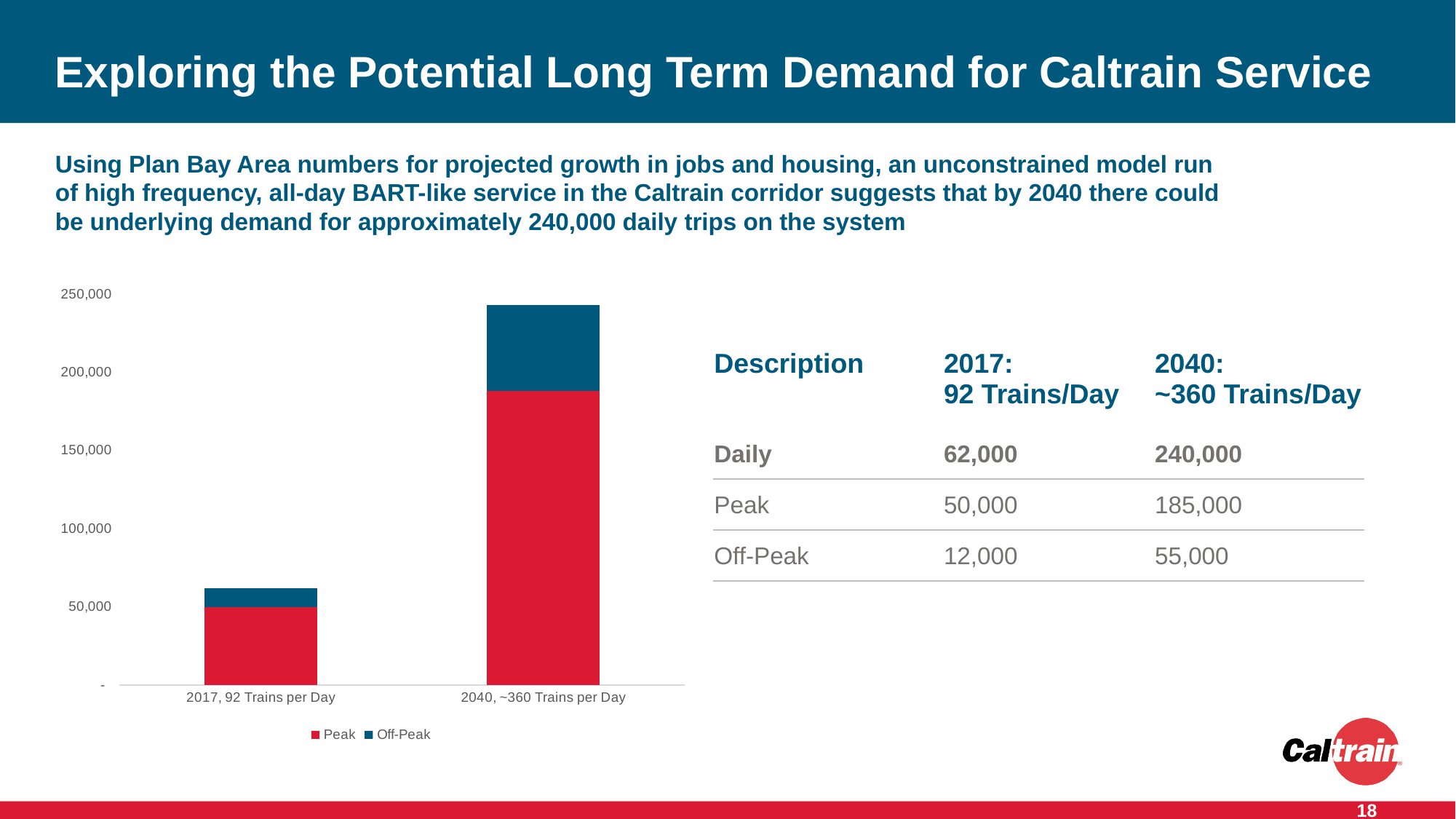
Which series is shown in red in the chart? Peak Which category has the taller stacked bar in the chart? 2040, ~360 Trains per Day Is the total stacked bar for 2017, 92 Trains per Day greater or less than 100,000? less What kind of chart is shown on the slide? Stacked bar chart How many series does the chart legend list? 2 Is the Peak segment for 2040, ~360 Trains per Day greater or less than 150,000? greater How many categories are shown on the x axis of the chart? 2 Is the total stacked bar for 2040, ~360 Trains per Day greater or less than 200,000? greater Which category has the shorter stacked bar in the chart? 2017, 92 Trains per Day According to the slide, what is the Peak value for 2040? 185,000 According to the slide, what is the Off-Peak value for 2017? 12,000 According to the slide, what is the total Daily value for 2040? 240,000